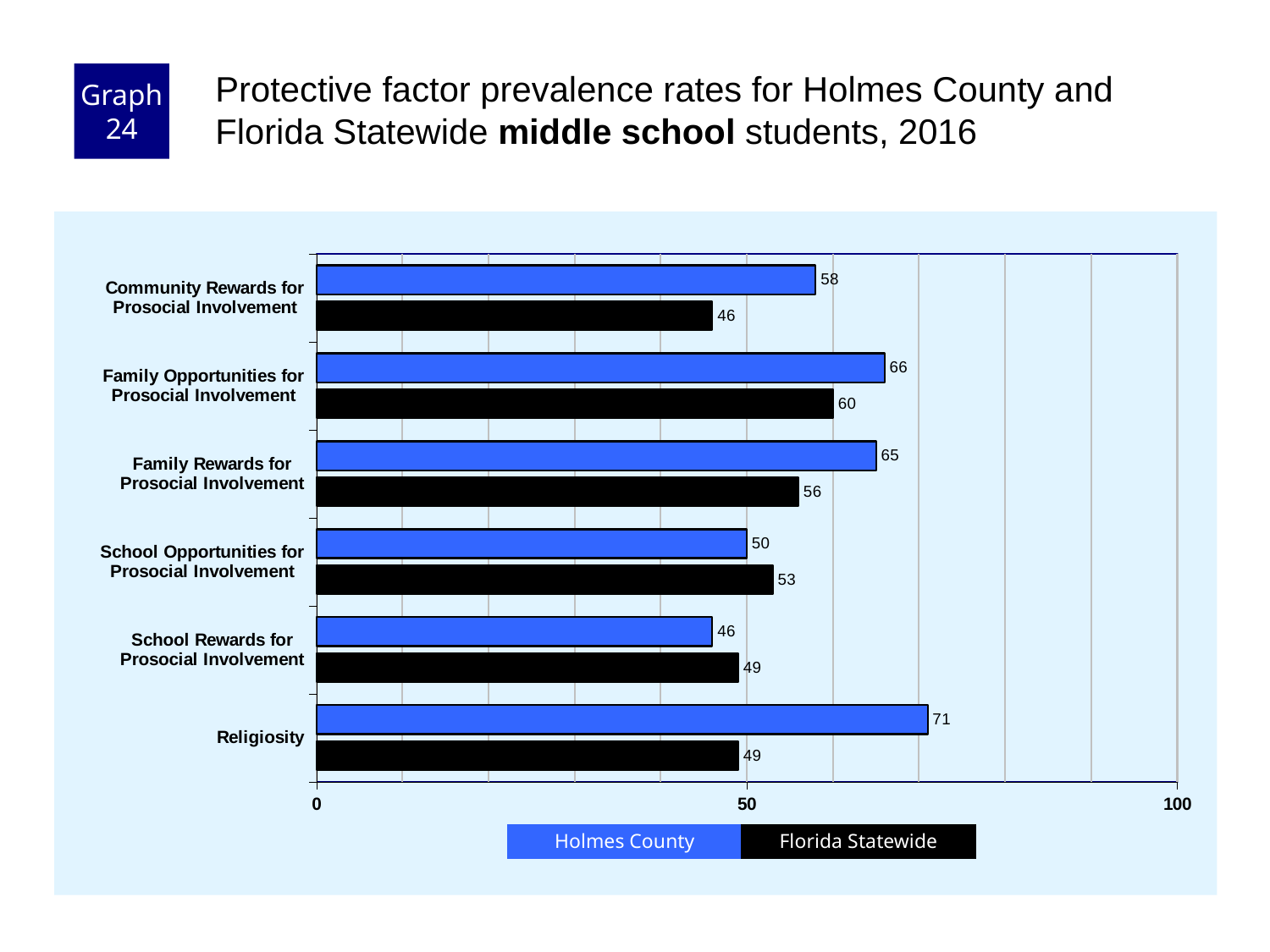
Which category has the highest Holmes County value? Religiosity Which colour represents Florida Statewide in the chart? black How many series does the legend list? 2 What is the Florida Statewide value for Family Opportunities for Prosocial Involvement? 60 What kind of chart is shown on the slide? bar chart What is the Holmes County value for School Opportunities for Prosocial Involvement? 50 How many categories are shown on the chart? 6 What is the Holmes County value for Religiosity? 71 What is the difference between the Holmes County and Florida Statewide values for Religiosity? 22 Which category has the lowest Florida Statewide value? Community Rewards for Prosocial Involvement Is the Holmes County value for Community Rewards for Prosocial Involvement greater or less than 50? greater For School Rewards for Prosocial Involvement, which is larger: Holmes County or Florida Statewide? Florida Statewide